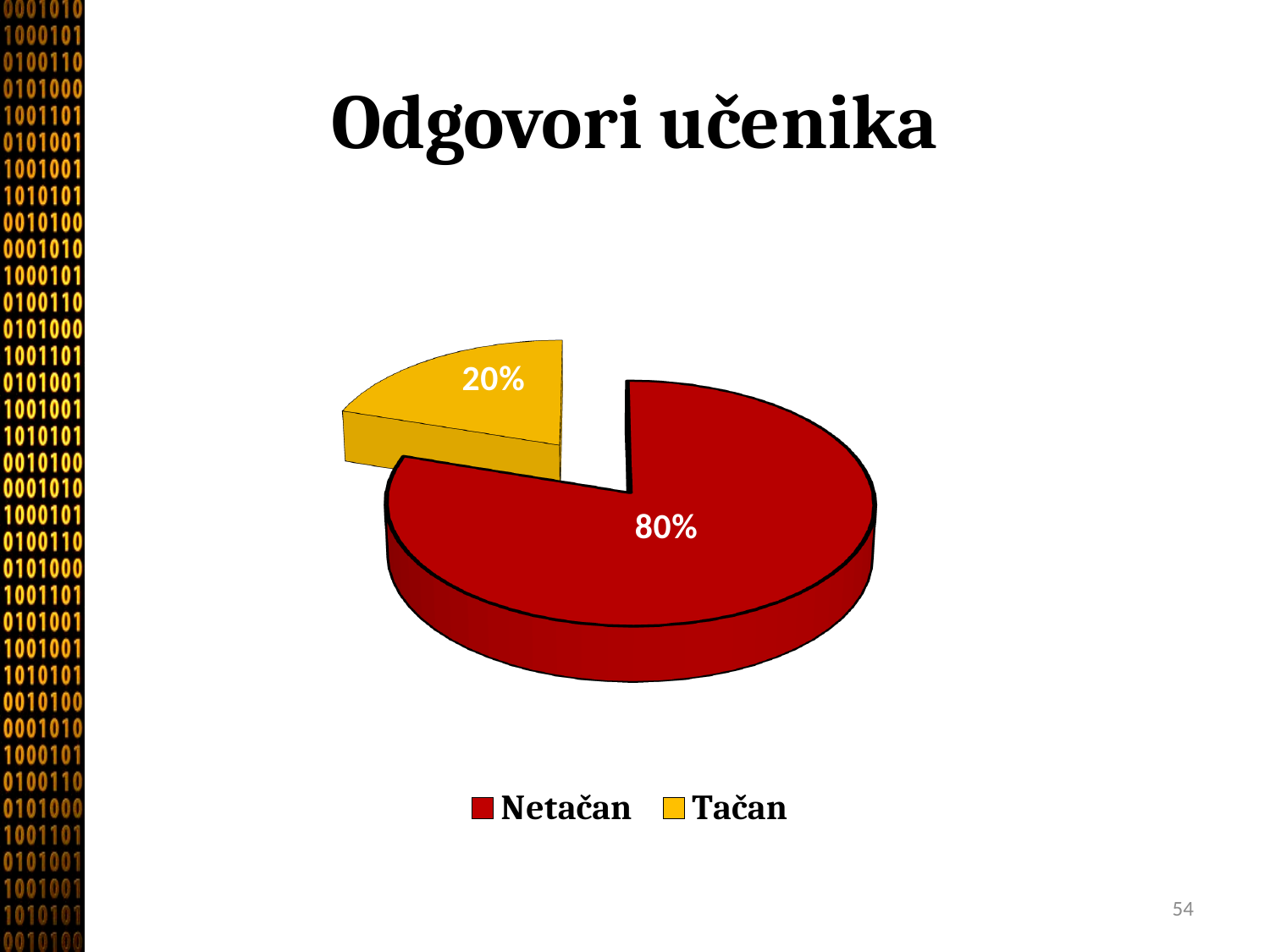
What kind of chart is shown on the slide? pie chart What is the value for Tačan? 20% How many entries does the legend list? 2 Which category has the largest share of the pie? Netačan What is the value for Netačan? 80% Which is larger, the share for Netačan or the share for Tačan? Netačan What share of the pie does the Tačan slice represent? 20% What is the title of the slide containing the chart? Odgovori učenika What is the difference between the Netačan and Tačan shares? 60% How many slices does the pie chart have? 2 Which category has the smallest share of the pie? Tačan What colour is the Netačan slice? red